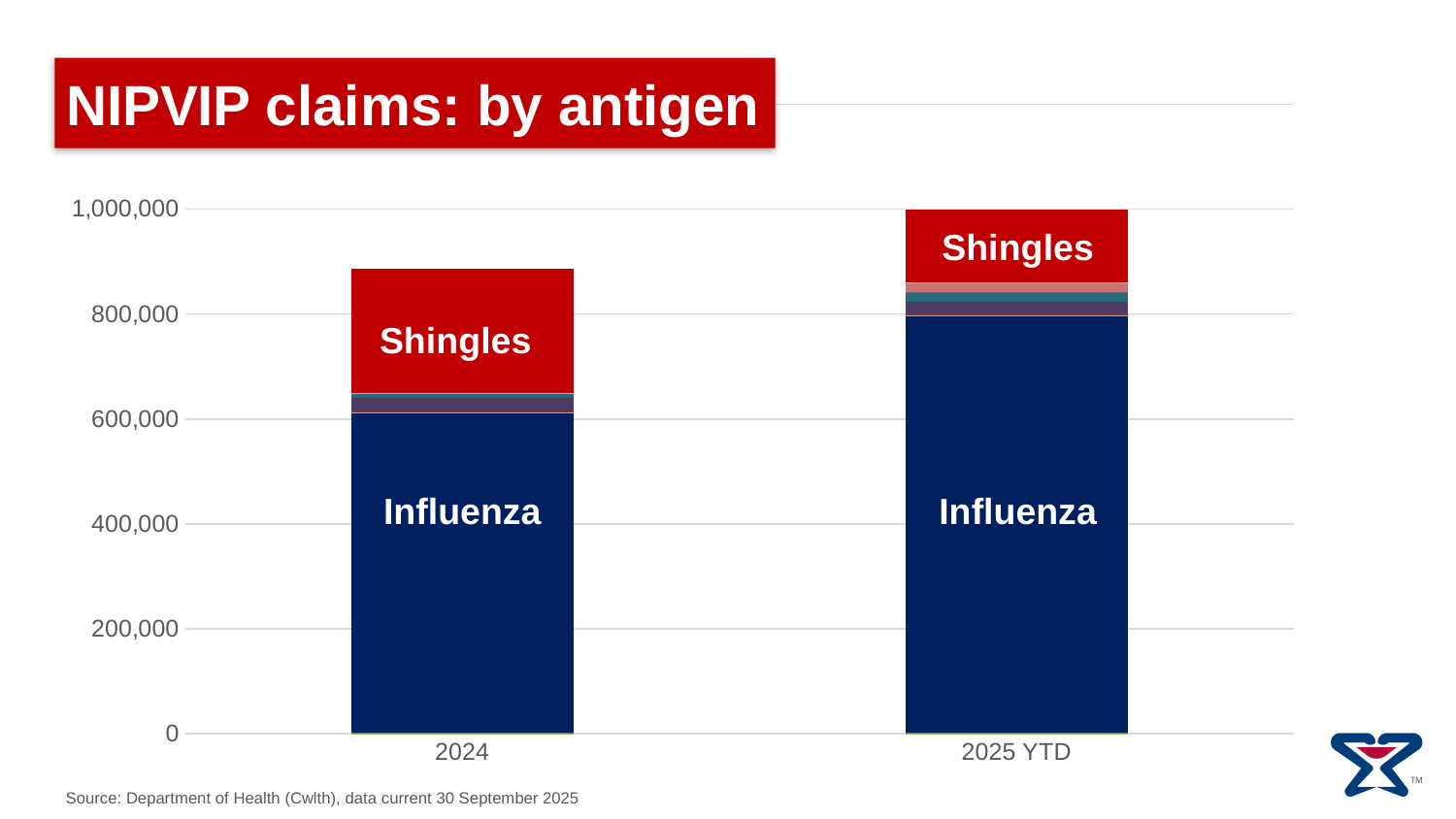
What is the title of the chart? NIPVIP claims: by antigen What kind of chart is shown on the slide? Stacked bar chart How many categories are shown on the x axis? 2 Do total claims rise or fall from 2024 to 2025 YTD? rise Is the total for 2025 YTD greater or less than 800,000? greater In 2024, which segment is larger, Influenza or Shingles? Influenza Is the total for 2024 greater or less than 1,000,000? less What are the two categories on the x axis? 2024 and 2025 YTD Which category has the lowest total claims? 2024 Is the total for 2024 greater or less than 800,000? greater Which category has the taller stacked bar, 2024 or 2025 YTD? 2025 YTD